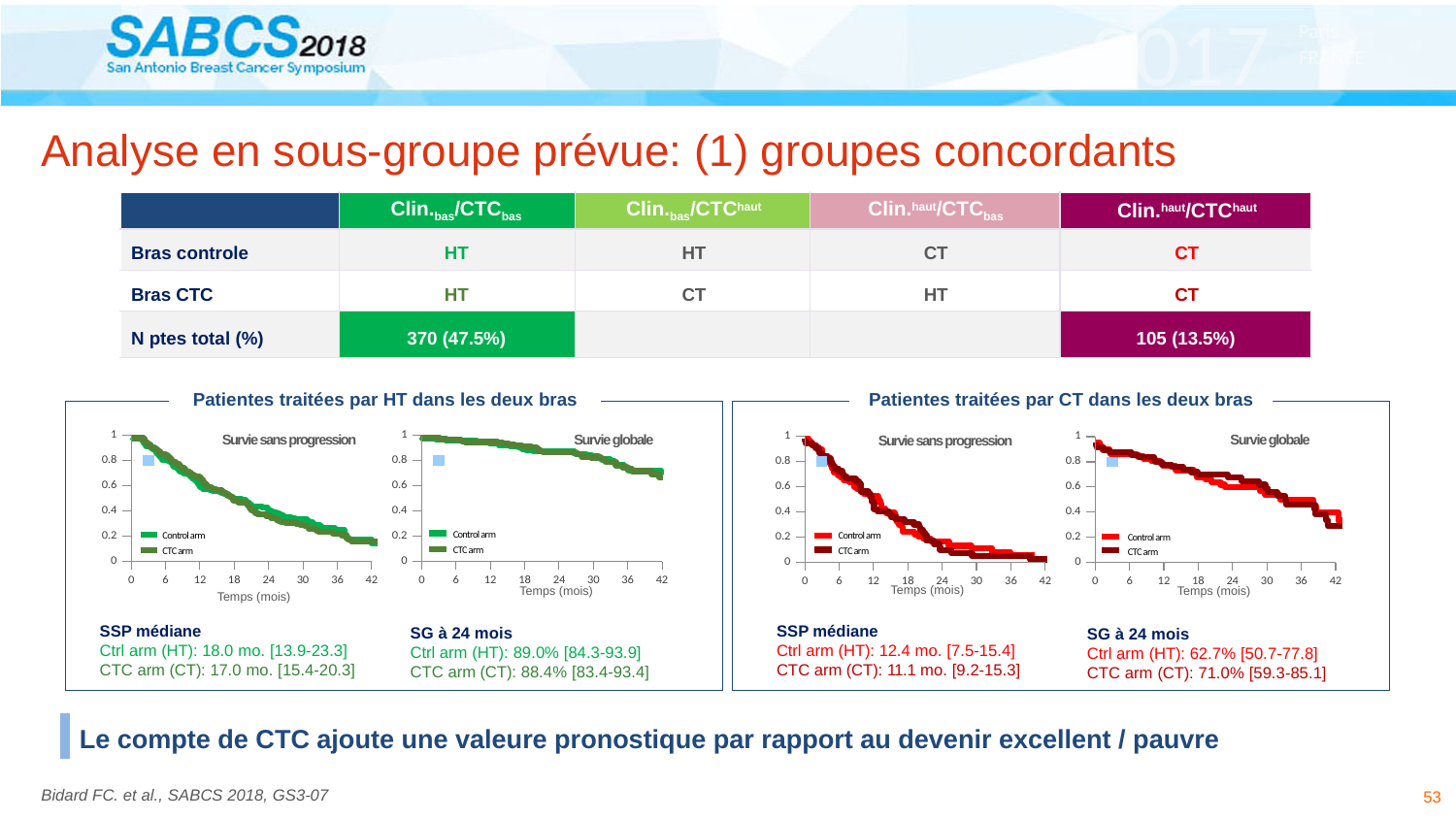
In the 'Survie sans progression' chart of the CT panel, is the value of the CTC arm curve at 36 months greater or less than 0.2? less In the 'Survie globale' chart of the HT panel, do the curves rise or fall as time (Temps, mois) increases? Fall For the 'Patientes traitées par CT dans les deux bras' panel, what is the SG à 24 mois reported for the CTC arm (CT)? 71.0% In the 'Survie globale' chart of the CT panel, is the value of the Control arm curve at 42 months greater or less than 0.5? less What is the label of the x axis on the 'Survie sans progression' chart in the CT panel? Temps (mois) In the 'Survie globale' chart of the 'Patientes traitées par CT dans les deux bras' panel, how many series does the legend list? 2 For the 'Patientes traitées par CT dans les deux bras' panel, which arm has the higher SG à 24 mois, Ctrl arm (HT) or CTC arm (CT)? CTC arm (CT) What kind of chart is the 'Survie sans progression' chart in the 'Patientes traitées par HT dans les deux bras' panel? Line chart (Kaplan-Meier survival curve) In the 'Survie sans progression' chart of the CT panel, how many tick marks are shown on the x axis? 8 In the 'Survie globale' chart of the HT panel, is the value of the Control arm curve at 42 months greater or less than 0.5? greater For the 'Patientes traitées par HT dans les deux bras' panel, what is the median SSP (SSP médiane) reported for the Ctrl arm (HT)? 18.0 mo. In the 'Survie sans progression' chart of the HT panel, what are the two legend entries? Control arm, CTC arm